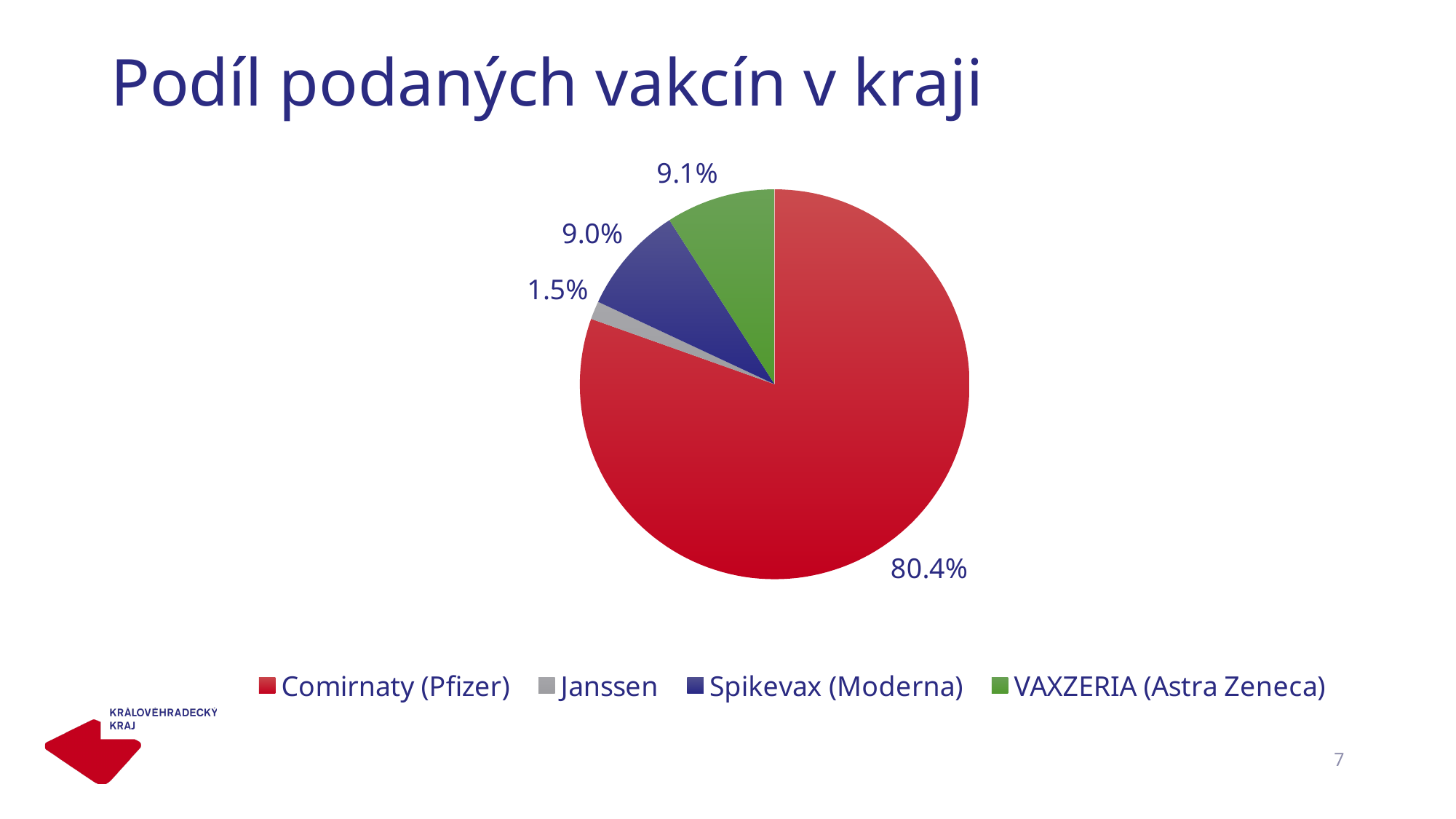
What is the title of the slide containing the pie chart? Podíl podaných vakcín v kraji What type of chart is shown on the slide? pie chart What share of the pie does Spikevax (Moderna) have? 9.0% Which vaccine has the smallest share of the pie? Janssen What share of the pie does VAXZERIA (Astra Zeneca) have? 9.1% Which vaccine has the largest share of the pie? Comirnaty (Pfizer) What share of the pie does Janssen have? 1.5% Which has a larger share, Spikevax (Moderna) or Janssen? Spikevax (Moderna) What share of the pie does Comirnaty (Pfizer) have? 80.4% How many slices does the pie chart have? 4 What is the difference in percentage points between the shares of VAXZERIA (Astra Zeneca) and Spikevax (Moderna)? 0.1 What is the difference in percentage points between the shares of Comirnaty (Pfizer) and Janssen? 78.9